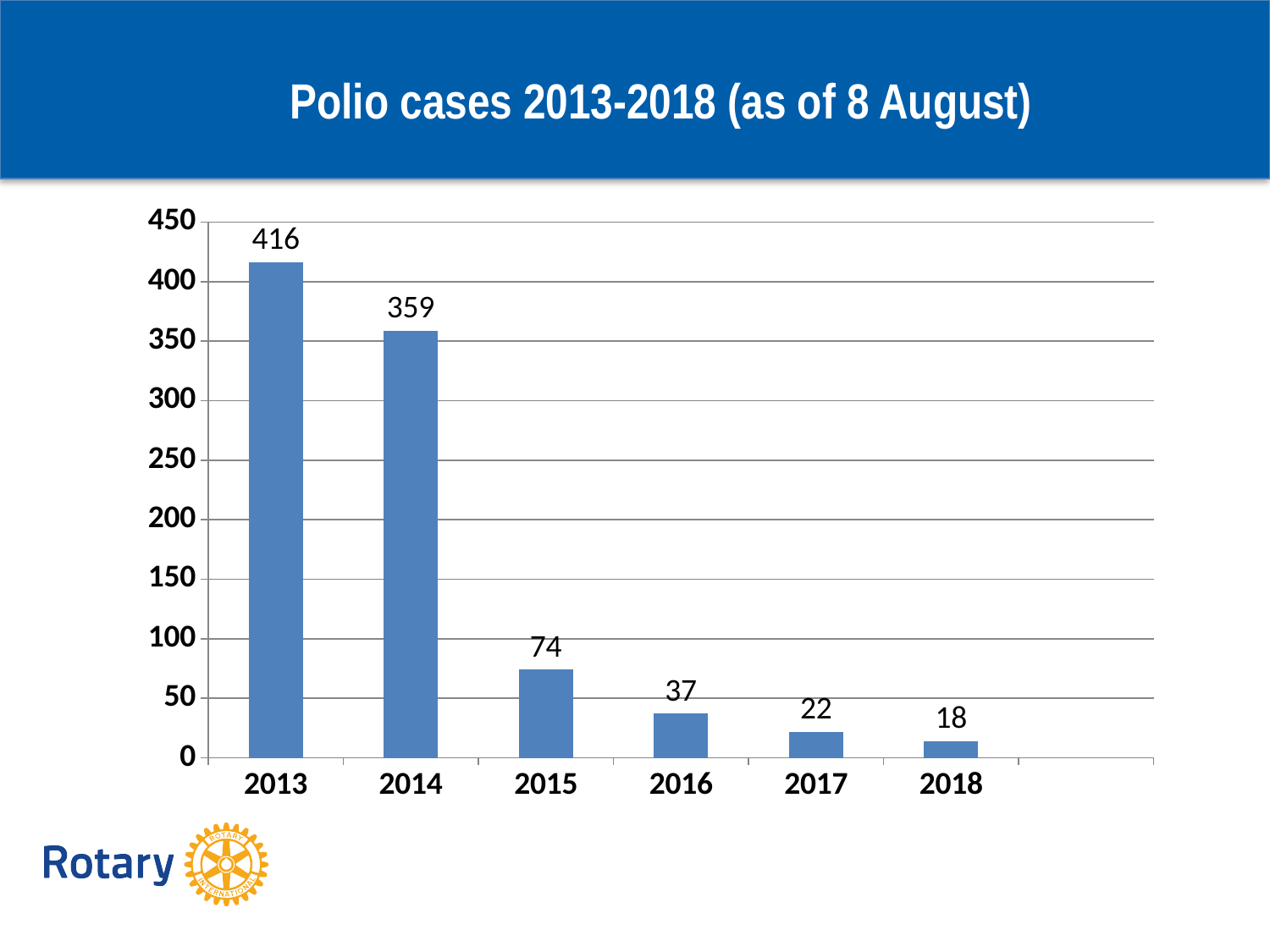
What kind of chart is shown on the slide? bar chart What is the value for 2018? 18 What is the difference between the values for 2016 and 2017? 15 How many polio cases are shown for 2013? 416 Which year has the highest number of polio cases? 2013 Is the value for 2014 greater or less than 350? greater Do the values rise or fall from 2013 to 2018? fall What is the difference between the values for 2013 and 2014? 57 Which year has the lowest number of polio cases? 2018 What is the value for 2015? 74 Which is larger, the value for 2015 or the value for 2016? 2015 How many years are shown on the x axis? 6